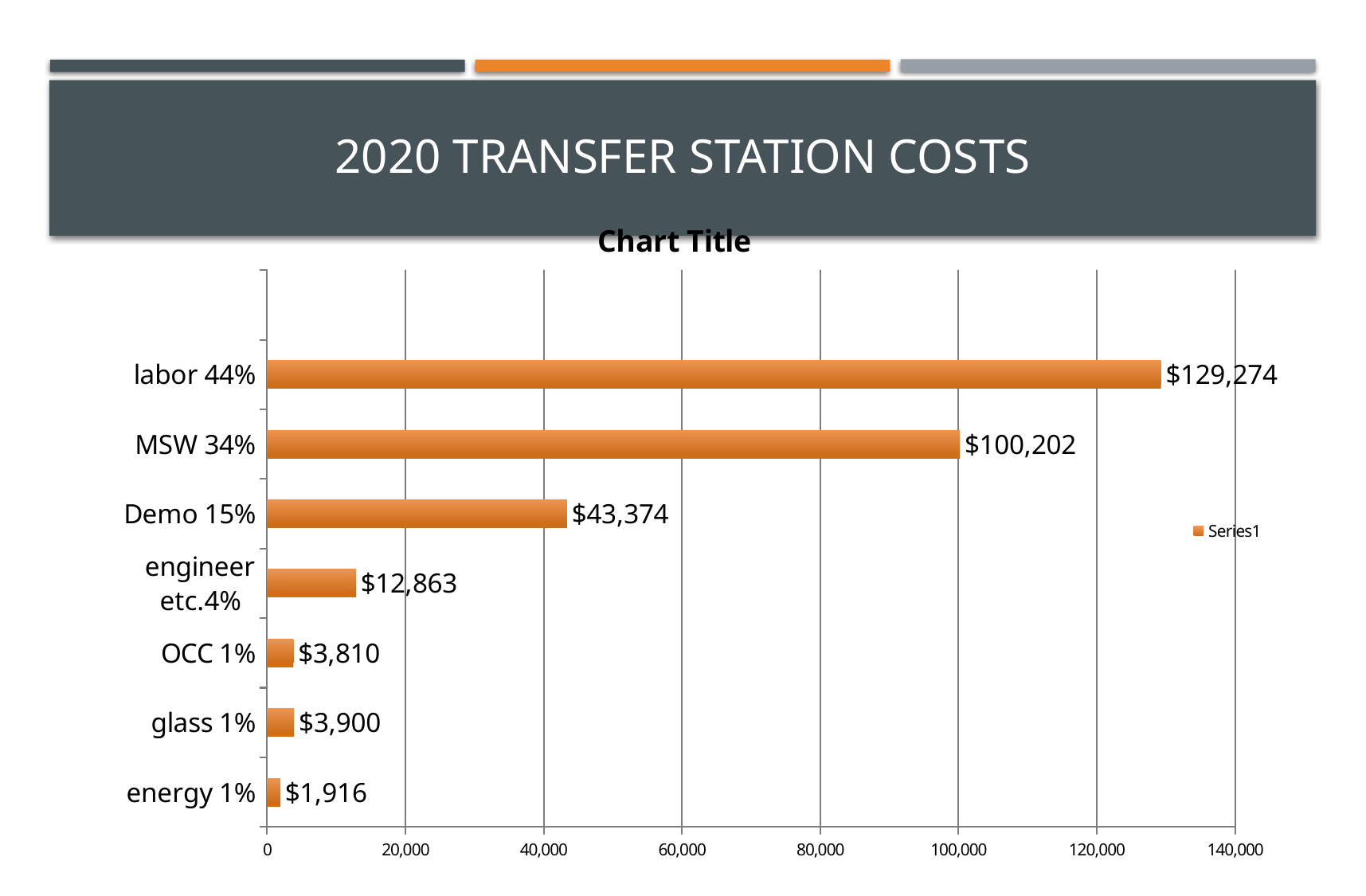
What is the difference between the values for glass 1% and OCC 1%? $90 What is the value for energy 1%? $1,916 What is the difference between the values for labor 44% and MSW 34%? $29,072 What is the value for labor 44%? $129,274 Which category has the highest value? labor 44% How many categories are shown in the chart? 7 Is the value for MSW 34% greater or less than 80,000? greater What is the value for Demo 15%? $43,374 What series name does the legend list? Series1 Which category has the lowest value? energy 1% Which is larger, the value for Demo 15% or the value for engineer etc.4%? Demo 15% What kind of chart is shown on the slide? bar chart